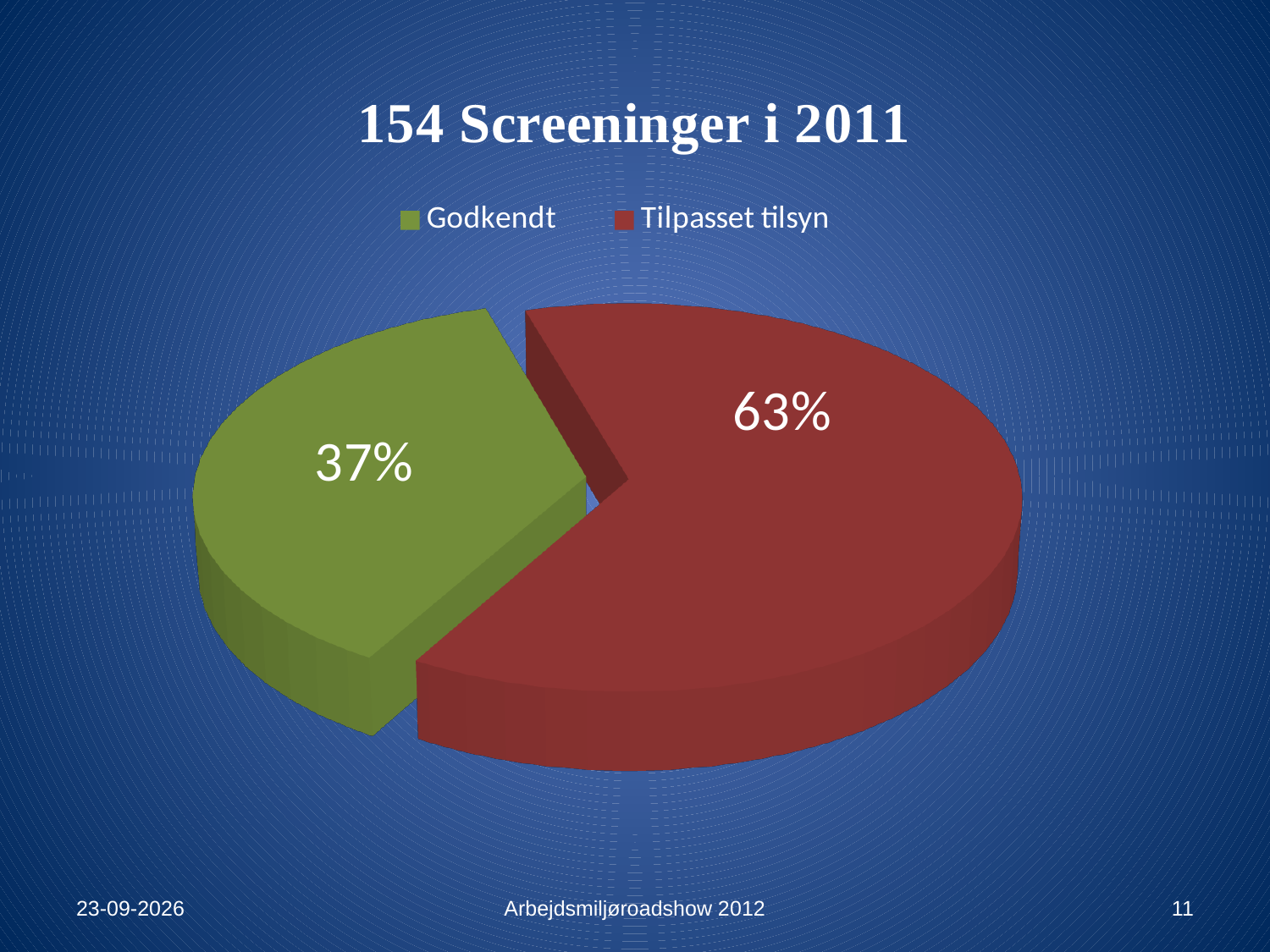
What colour is the Godkendt slice? green What kind of chart is shown on the slide? pie chart How many entries does the legend list? 2 Which category has the largest slice? Tilpasset tilsyn How many slices does the pie chart have? 2 Which category has the smallest slice? Godkendt What share of the pie is Godkendt? 37% What share of the pie is Tilpasset tilsyn? 63% Which is larger, Godkendt or Tilpasset tilsyn? Tilpasset tilsyn What is the difference in percentage points between Tilpasset tilsyn and Godkendt? 26 What is the title of the chart? 154 Screeninger i 2011